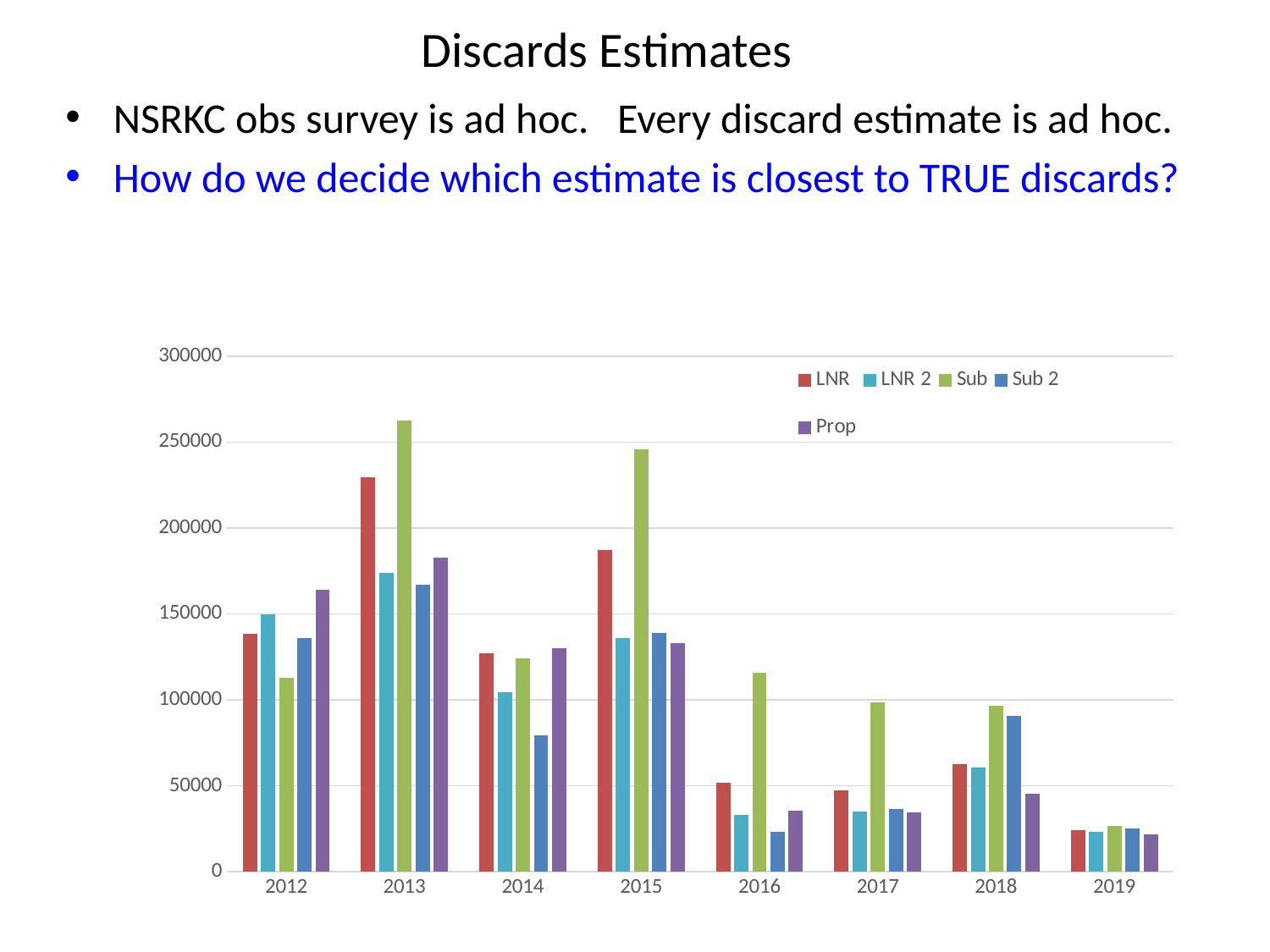
Does the Sub series rise or fall from 2016 to 2019? fall In 2015, which is larger, the Sub value or the LNR value? Sub Is the Sub value for 2013 greater or less than 250000? greater Is the Sub 2 value for 2014 greater or less than 100000? less Which series has the lowest value in 2016? Sub 2 Is the LNR value for 2013 greater or less than 200000? greater In which year is the Sub series highest? 2013 What colour are the bars for the Sub series? green What kind of chart is shown on the slide? bar chart How many years are shown on the x axis? 8 In 2012, which is larger, the Prop value or the LNR value? Prop How many series does the legend list? 5